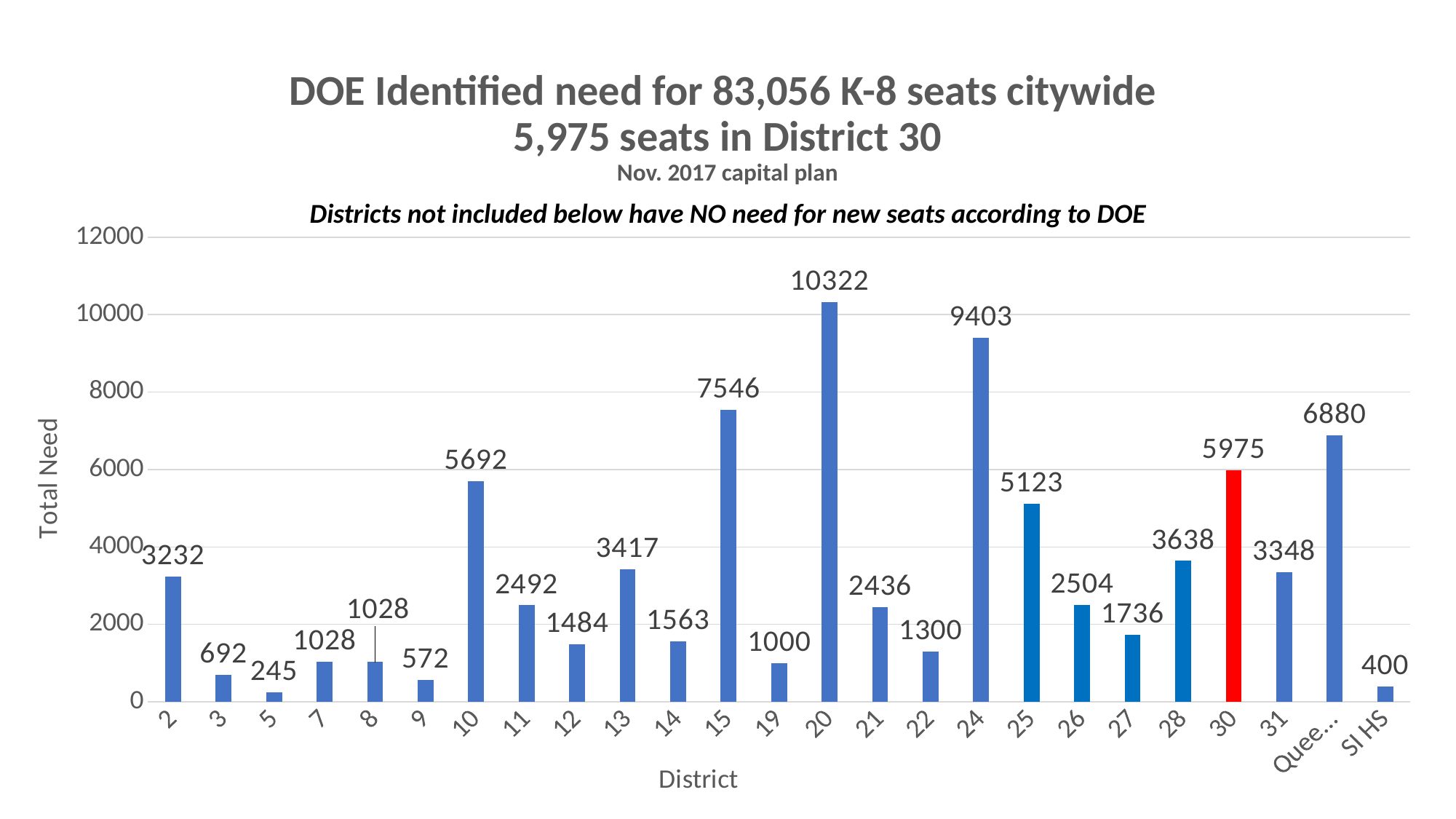
Which has a larger total need, District 15 or District 10? District 15 Is the value for District 24 greater or less than 8000? greater What kind of chart is shown on the slide? bar chart Which district has the lowest total need? 5 What is the total need for SI HS? 400 Which district has the highest total need? 20 What is the total need for District 20? 10322 What is the total need for District 30? 5975 How many districts/categories are shown on the x axis? 25 What is the difference in total need between District 20 and District 24? 919 Which bar is highlighted in red? District 30 What is the difference in total need between District 30 and District 25? 852